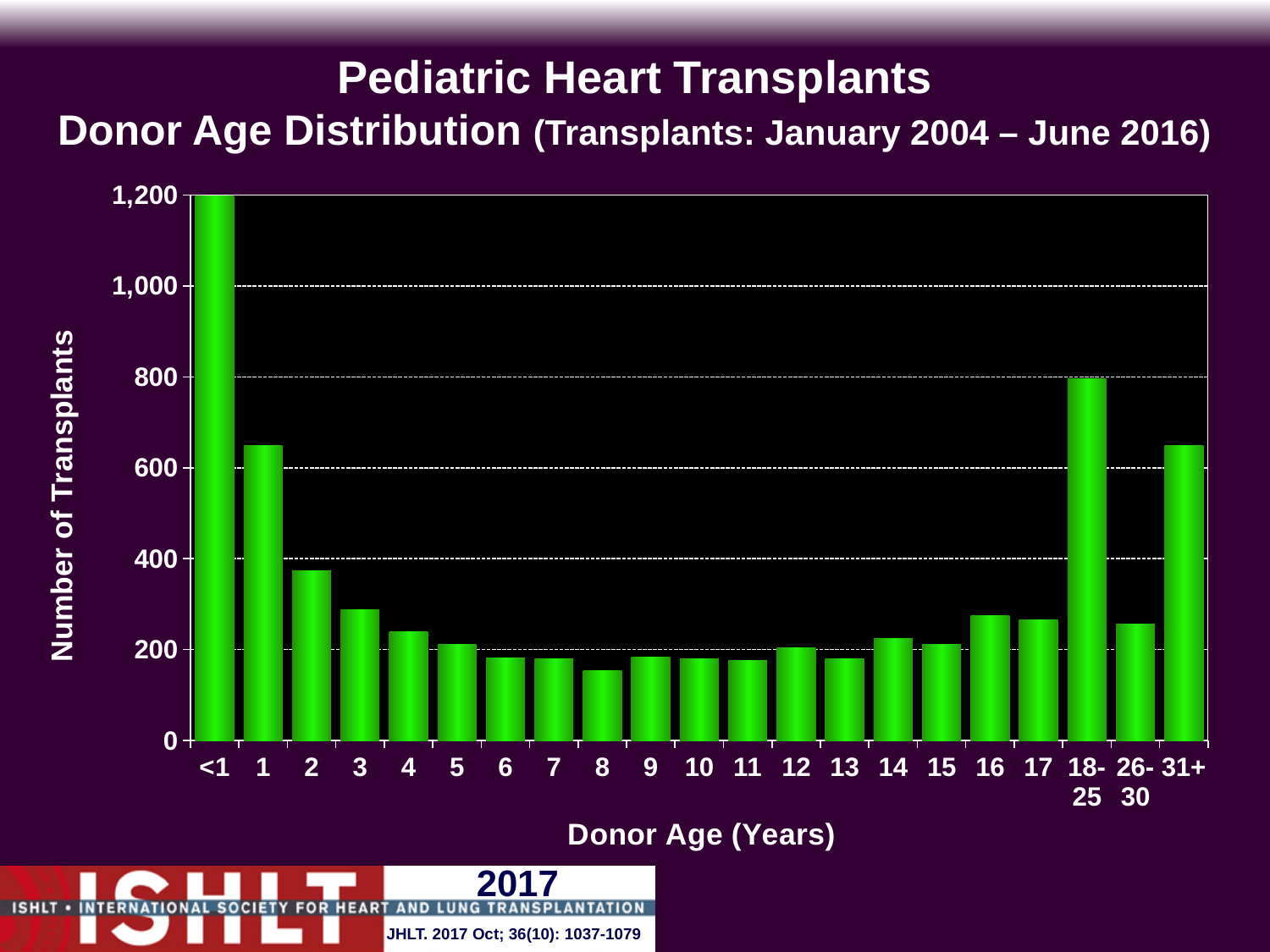
Is the number of transplants for donor age 2 greater or less than 400? less What is the label of the y axis? Number of Transplants Is the number of transplants for donor age 18-25 greater or less than 600? greater Which has more transplants: donor age 18-25 or donor age 26-30? 18-25 Which donor age category has the highest number of transplants? <1 Which donor age category has the lowest number of transplants? 8 What type of chart is shown on the slide? Bar chart Do the number of transplants rise or fall from donor age 1 to donor age 8? fall Is the number of transplants for donor age 8 greater or less than 200? less How many donor age categories are shown on the x axis? 21